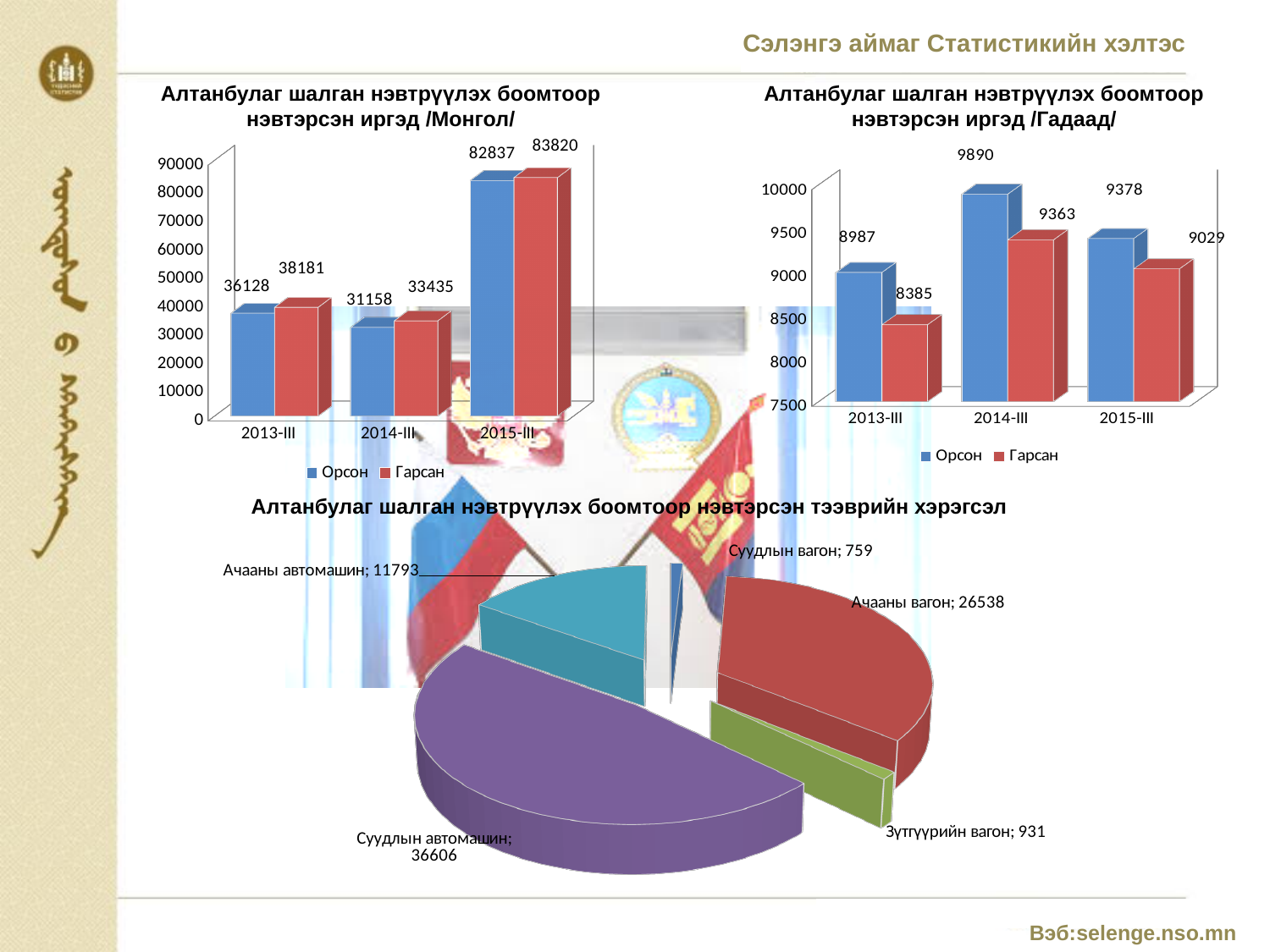
In the top-right chart (Гадаад), is Орсон or Гарсан larger for 2015-III? Орсон In the bottom pie chart, what is the value for Ачааны вагон? 26538 In the top-left chart (Монгол), what is the value of Орсон for 2015-III? 82837 In the top-right chart (Гадаад), which period has the highest Орсон value? 2014-III In the top-right chart (Гадаад), what is the difference between Орсон and Гарсан for 2014-III? 527 In the top-left chart (Монгол), what is the difference between Гарсан and Орсон for 2013-III? 2053 In the top-right chart (Гадаад), what is the value of Гарсан for 2013-III? 8385 How many categories does the bottom pie chart show? 5 In the bottom pie chart, which category has the largest value? Суудлын автомашин In the top-left chart (Монгол), which period has the lowest Орсон value? 2014-III How many series does the legend of the top-left chart (Монгол) list? 2 In the top-left chart (Монгол), what is the value of Гарсан for 2014-III? 33435